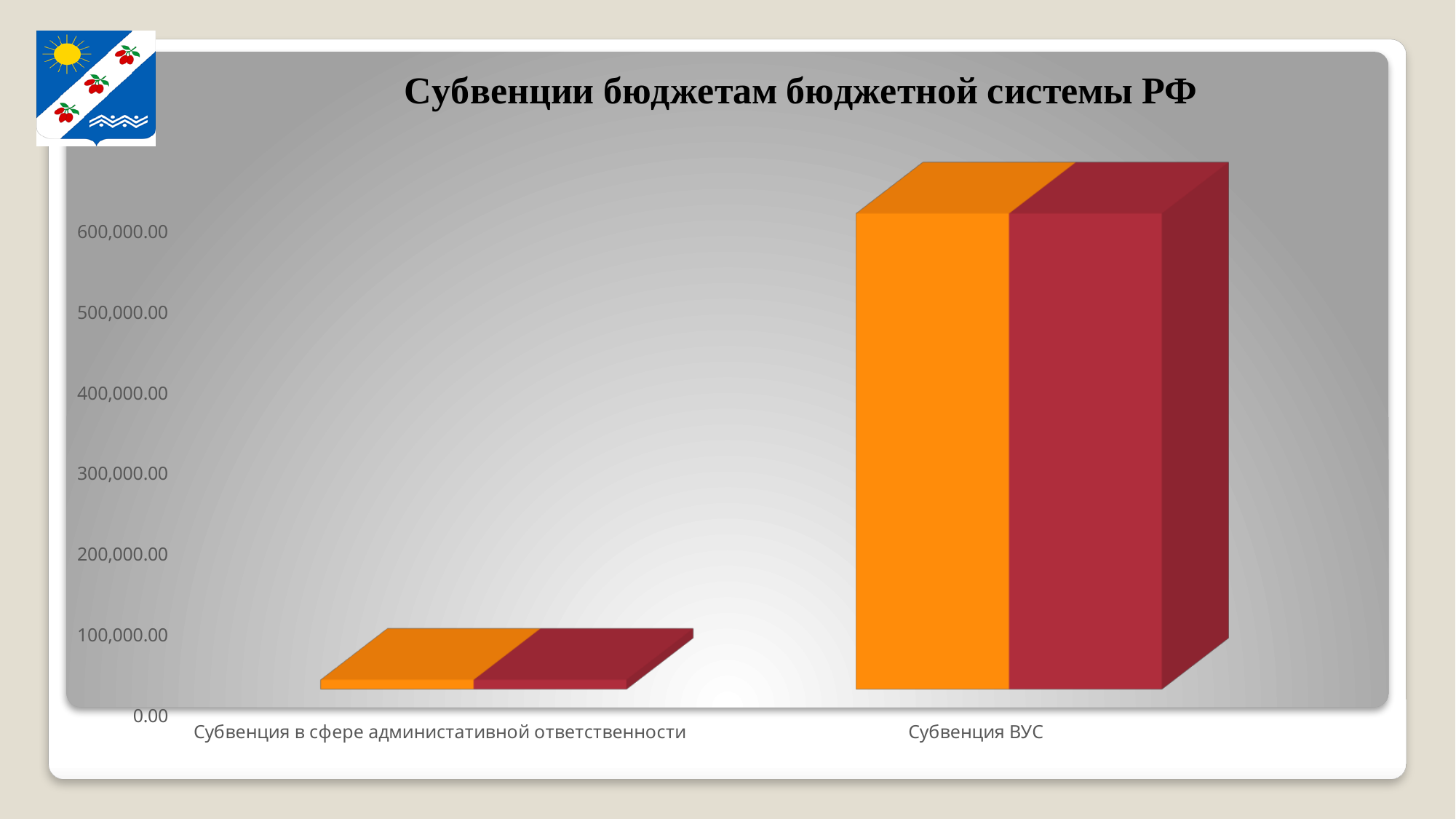
Is the value of the red bar for Субвенция в сфере администативной ответственности greater or less than 200,000.00? less How many categories are shown on the x axis of the chart? 2 How many bars are shown for the category Субвенция ВУС? 2 What kind of chart is shown on the slide? bar chart Which is larger: the orange bar for Субвенция ВУС or the orange bar for Субвенция в сфере администативной ответственности? Субвенция ВУС Is the value of the orange bar for Субвенция в сфере администативной ответственности greater or less than 100,000.00? less Is the value of the orange bar for Субвенция ВУС greater or less than 500,000.00? greater Which category has the highest values in the chart? Субвенция ВУС What is the highest value labelled on the vertical axis of the chart? 600,000.00 What is the title of the chart? Субвенции бюджетам бюджетной системы РФ Which category has the lowest values in the chart? Субвенция в сфере администативной ответственности